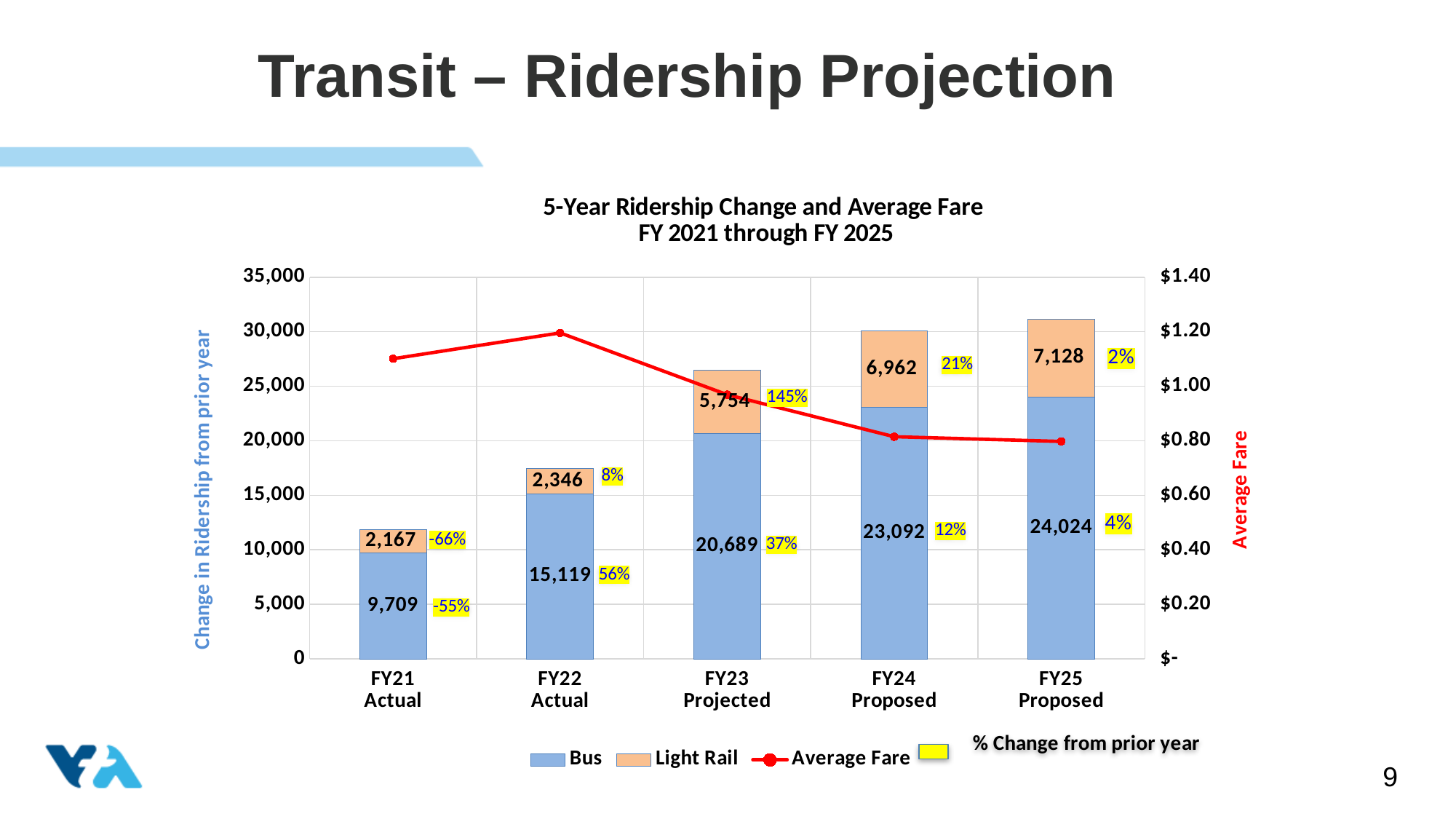
Is the Average Fare for FY25 Proposed greater or less than $1.00? less How many fiscal years are shown on the x axis? 5 What is the total of the stacked bar for FY25 Proposed? 31,152 What is the Bus value for FY23 Projected? 20,689 What is the difference between the Bus values for FY22 Actual and FY21 Actual? 5,410 Which fiscal year has the lowest Light Rail value? FY21 Actual Is the Average Fare for FY22 Actual greater or less than $1.00? greater Which is larger, the Light Rail value for FY23 Projected or for FY22 Actual? FY23 Projected What is the Light Rail value for FY24 Proposed? 6,962 Which fiscal year has the highest Bus value? FY25 Proposed What is the Bus value for FY21 Actual? 9,709 Does the Average Fare line rise or fall from FY22 Actual to FY25 Proposed? fall